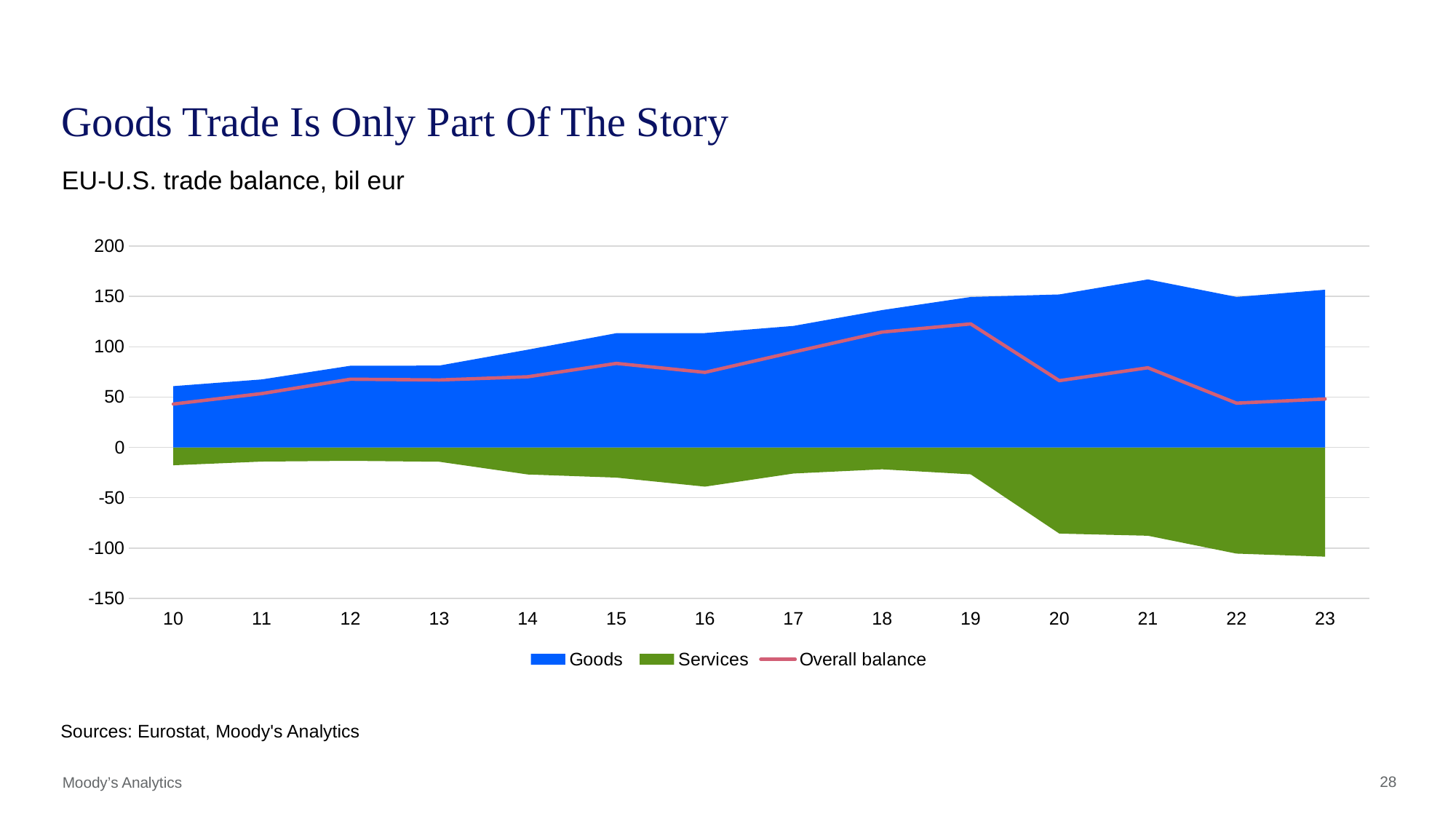
What kind of chart is shown on the slide? Area chart with a line overlay What colour represents the Services series? Green How many series does the legend list? 3 How many years are plotted along the x axis? 14 Is the Overall balance in year 22 greater or less than 50? less Is the Overall balance in year 18 greater or less than 100? greater Is the value for Goods in year 19 greater or less than 100? greater Does the Services series rise or fall from year 19 to year 23? fall In which year does the Overall balance line reach its highest point? 19 Which year has the larger Overall balance, 19 or 20? 19 In which year is the Goods series at its highest? 21